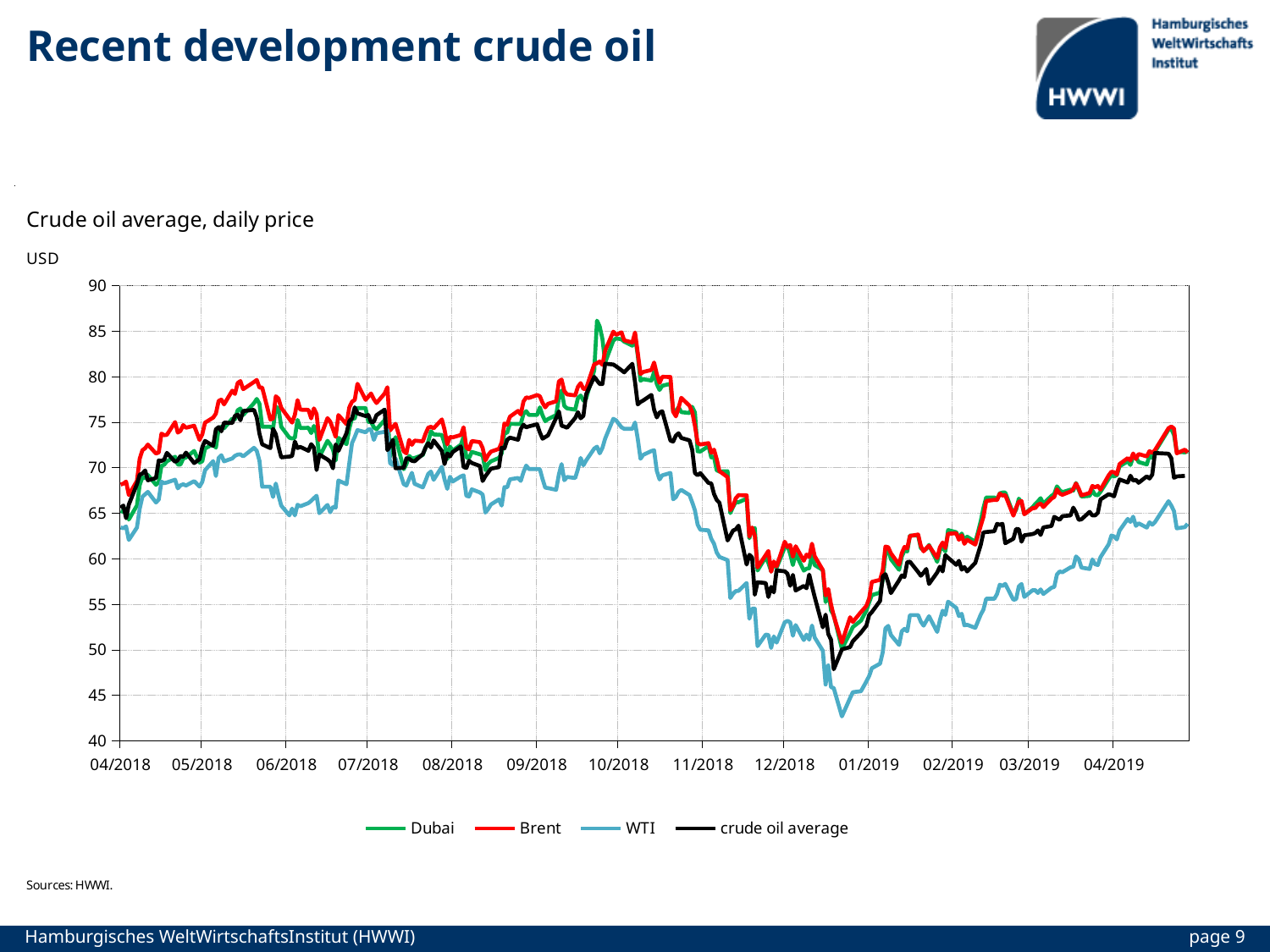
What kind of chart is shown on the slide? line chart Is the value of the crude oil average at the start of 04/2018 greater or less than 70? less How many series does the legend list? 4 Which series are listed in the legend? Dubai, Brent, WTI, crude oil average Is the lowest value reached by WTI (around the end of 12/2018) greater or less than 45? less In what unit are the prices on the y axis given? USD Do the crude oil prices rise or fall between 01/2019 and 04/2019? rise Is the value of WTI in 04/2019 greater or less than 70? less Do the crude oil prices rise or fall between 10/2018 and the end of 12/2018? fall Which series has the lowest values in 04/2019? WTI How many month labels are shown on the x axis? 13